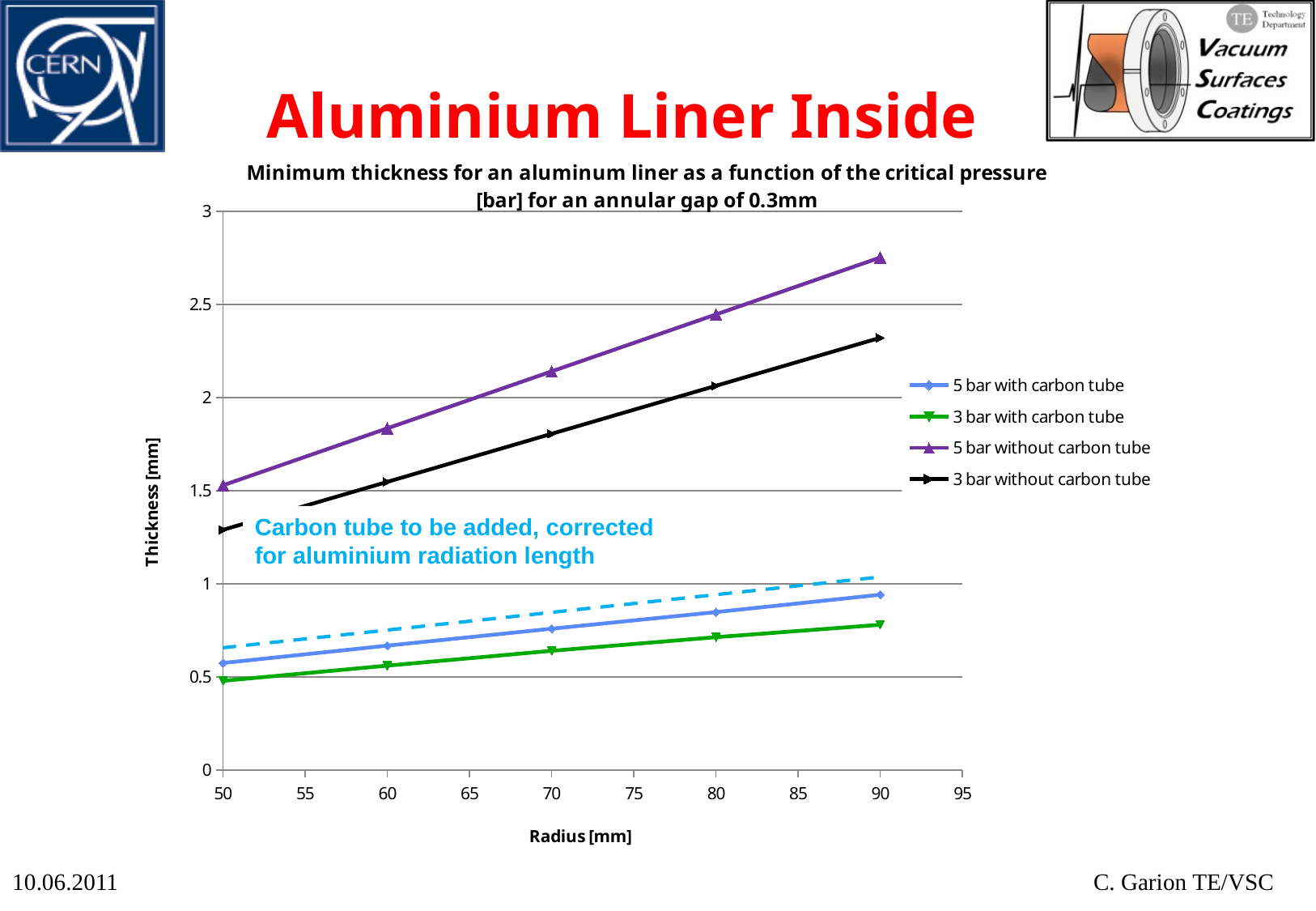
Is the thickness for '3 bar without carbon tube' at a radius of 90 mm greater or less than 2.5? less Which series has the lowest thickness at a radius of 90 mm? 3 bar with carbon tube Is the thickness for '5 bar with carbon tube' at a radius of 90 mm greater or less than 1? less Is the thickness for '3 bar without carbon tube' at a radius of 50 mm greater or less than 1.5? less Does the thickness for '3 bar with carbon tube' rise or fall as the radius increases? rise Which series has the highest thickness at a radius of 90 mm? 5 bar without carbon tube How many series does the legend list? 4 What kind of chart is shown on the slide? line chart At a radius of 70 mm, which is larger: the thickness for '5 bar without carbon tube' or for '3 bar without carbon tube'? 5 bar without carbon tube How many data points are plotted for the '5 bar without carbon tube' series? 5 What is the label of the x axis? Radius [mm]